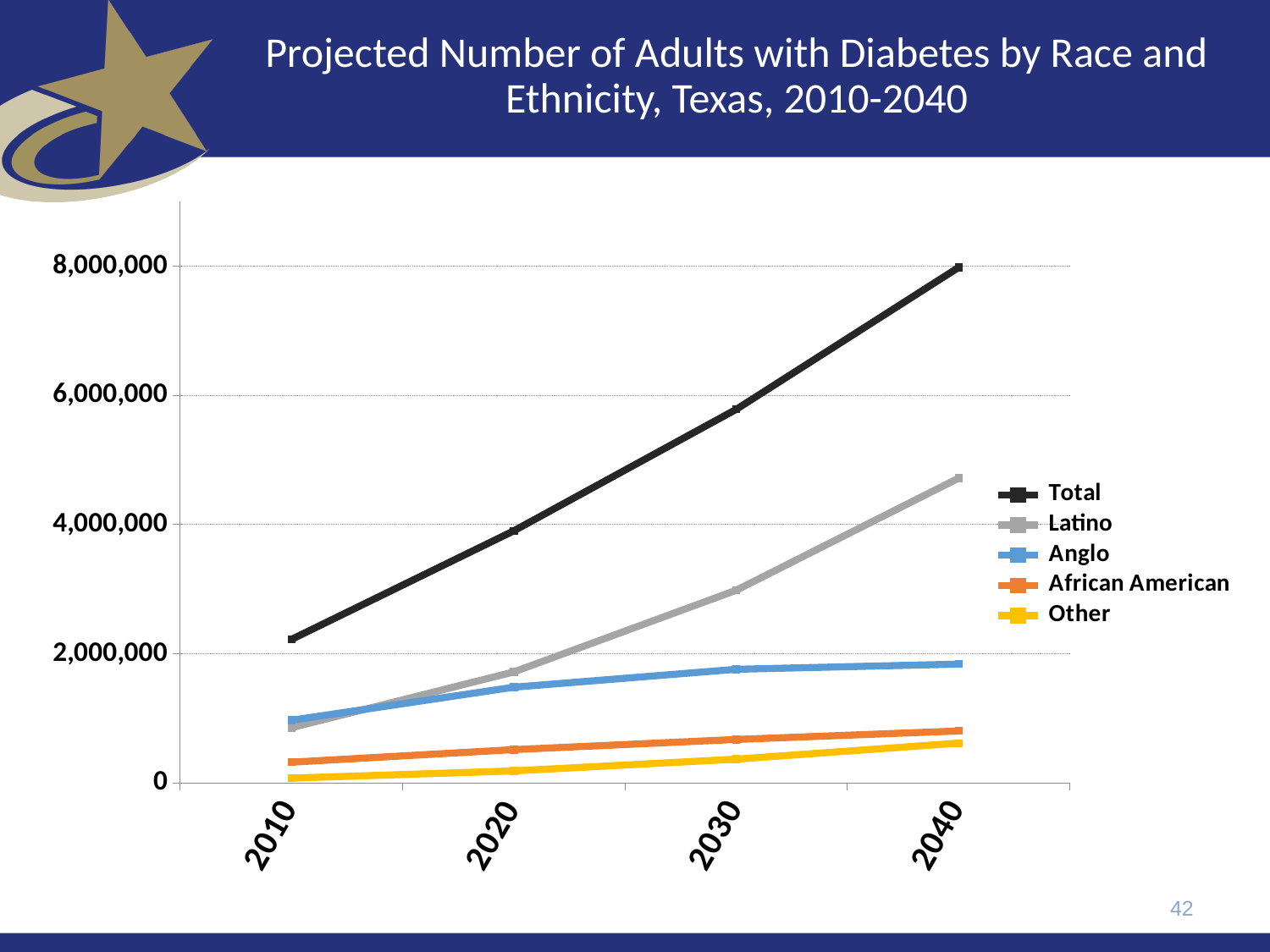
Which series has the lowest value in 2010? Other Is the Latino value for 2030 greater or less than 2,000,000? greater How many years are plotted along the x axis? 4 Is the Latino value for 2040 greater or less than 4,000,000? greater Which series has the highest value in 2040? Total What is the title of the chart? Projected Number of Adults with Diabetes by Race and Ethnicity, Texas, 2010-2040 How many series does the legend list? 5 What kind of chart is shown on the slide? line chart Is the Total value for 2010 greater or less than 4,000,000? less Which is larger in 2040, the Latino value or the Anglo value? Latino Does the Total series rise or fall from 2010 to 2040? rise